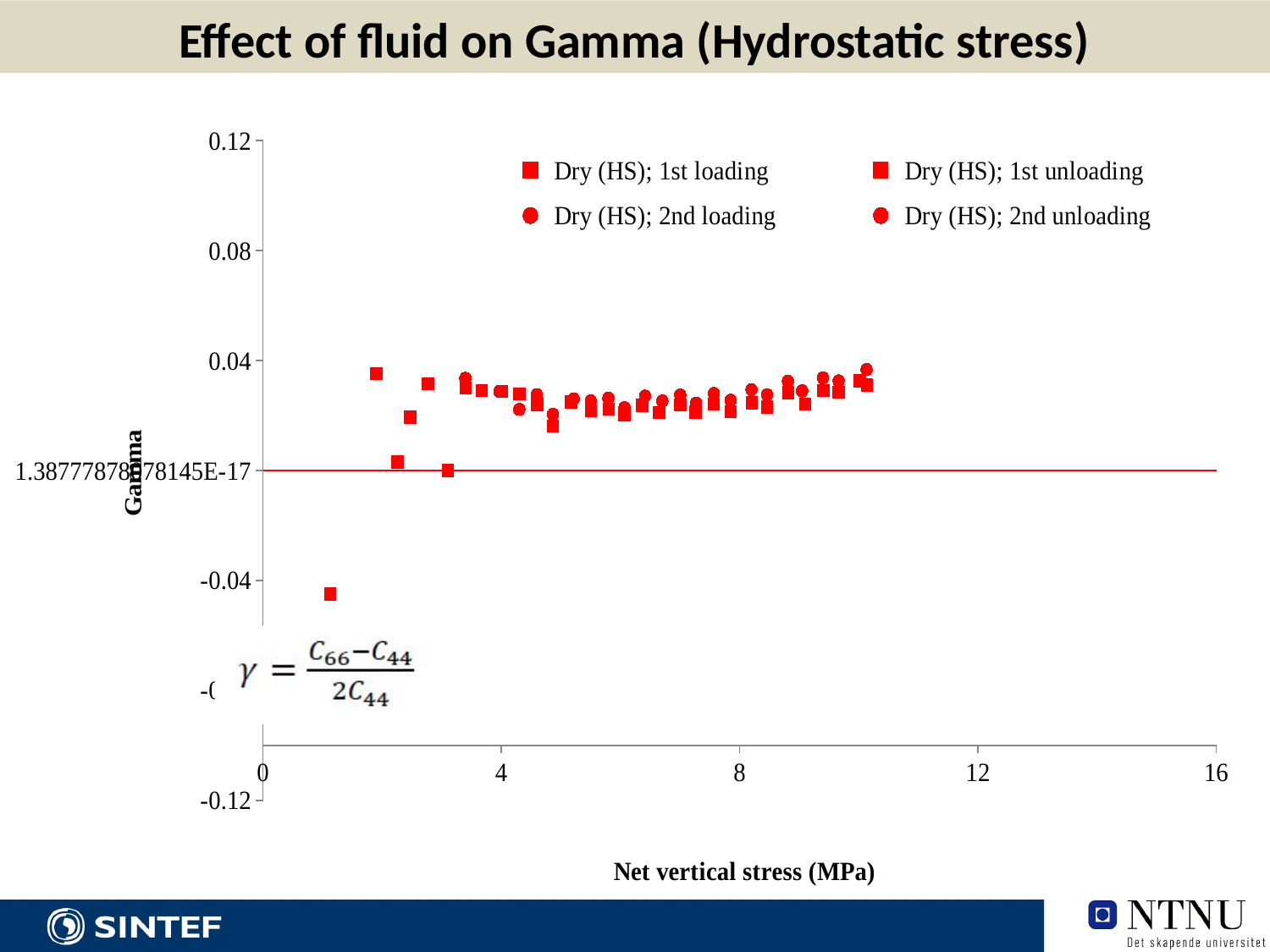
Are the plotted Gamma values at around 8 MPa net vertical stress greater or less than 0.04? less How many series does the legend list? 4 Is the Dry (HS); 1st loading value at about 1 MPa net vertical stress greater or less than 0? less Does the Dry (HS); 1st loading series rise or fall between about 1 MPa and 2 MPa net vertical stress? rise What is the title of the chart? Effect of fluid on Gamma (Hydrostatic stress) What is the maximum value shown on the x axis? 16 What kind of chart is shown on the slide? Scatter chart Which series has the lowest plotted Gamma value on the chart? Dry (HS); 1st loading What is the x-axis title of the chart? Net vertical stress (MPa) Are any of the plotted Gamma values greater than 0.08? No